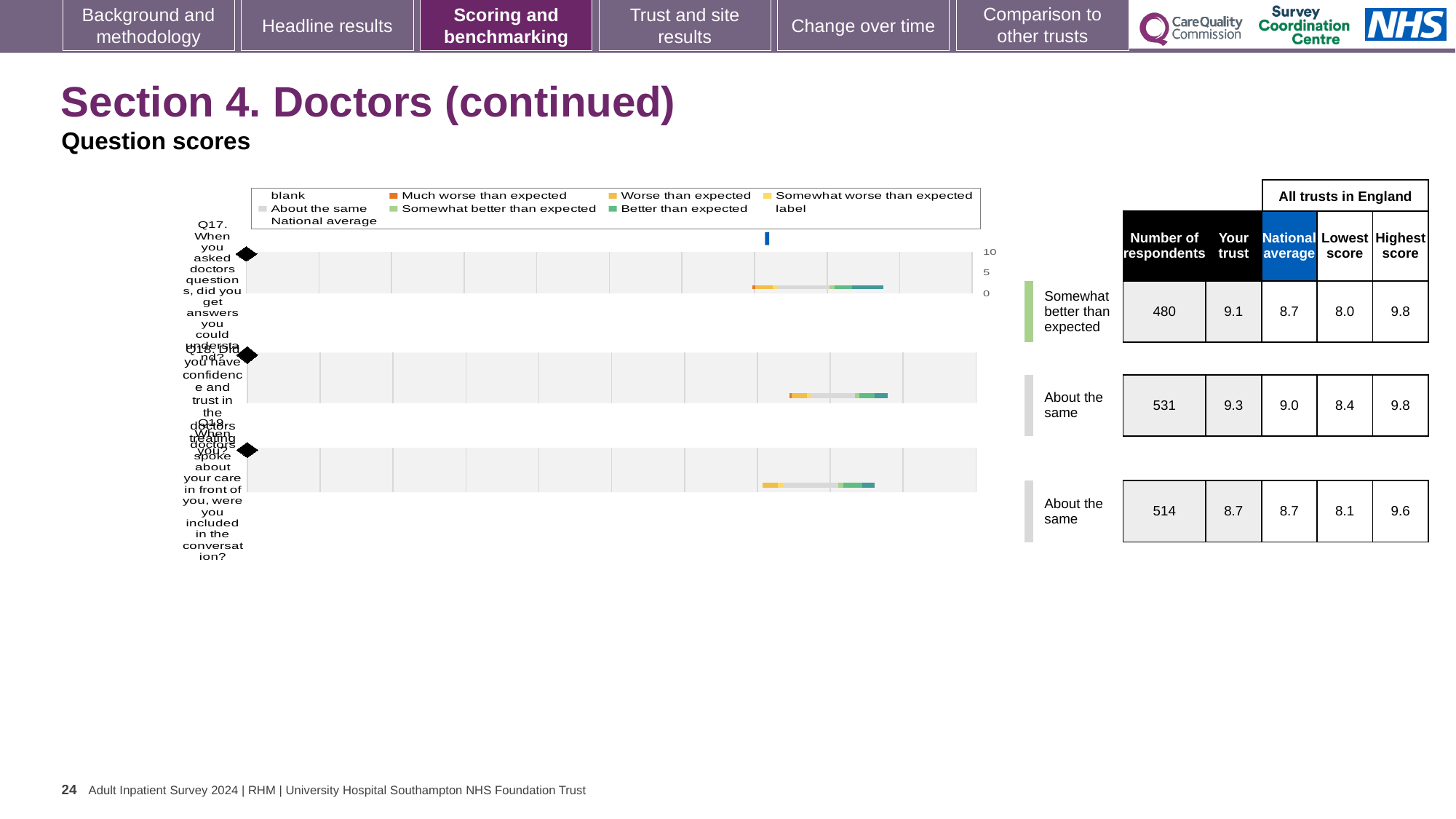
For Q17, what is the difference between the 'Your trust' score and the national average? 0.4 Which question has the lowest 'Your trust' score? Q19 What is the highest score among all trusts in England for Q19? 9.6 What benchmark category is shown for Q17? Somewhat better than expected For Q18, which is larger: the 'Your trust' score or the national average? Your trust What is the 'Your trust' score for Q17 (When you asked doctors questions, did you get answers you could understand?)? 9.1 What kind of chart is used to show the question scores on this slide? Bar chart What is the national average score for Q18 (Did you have confidence and trust in the doctors treating you?)? 9.0 How many questions (categories) are plotted in the chart? 3 Which question has the highest 'Your trust' score? Q18 How many respondents answered Q19 (When doctors spoke about your care in front of you, were you included in the conversation?)? 514 How many entries does the chart legend list? 9